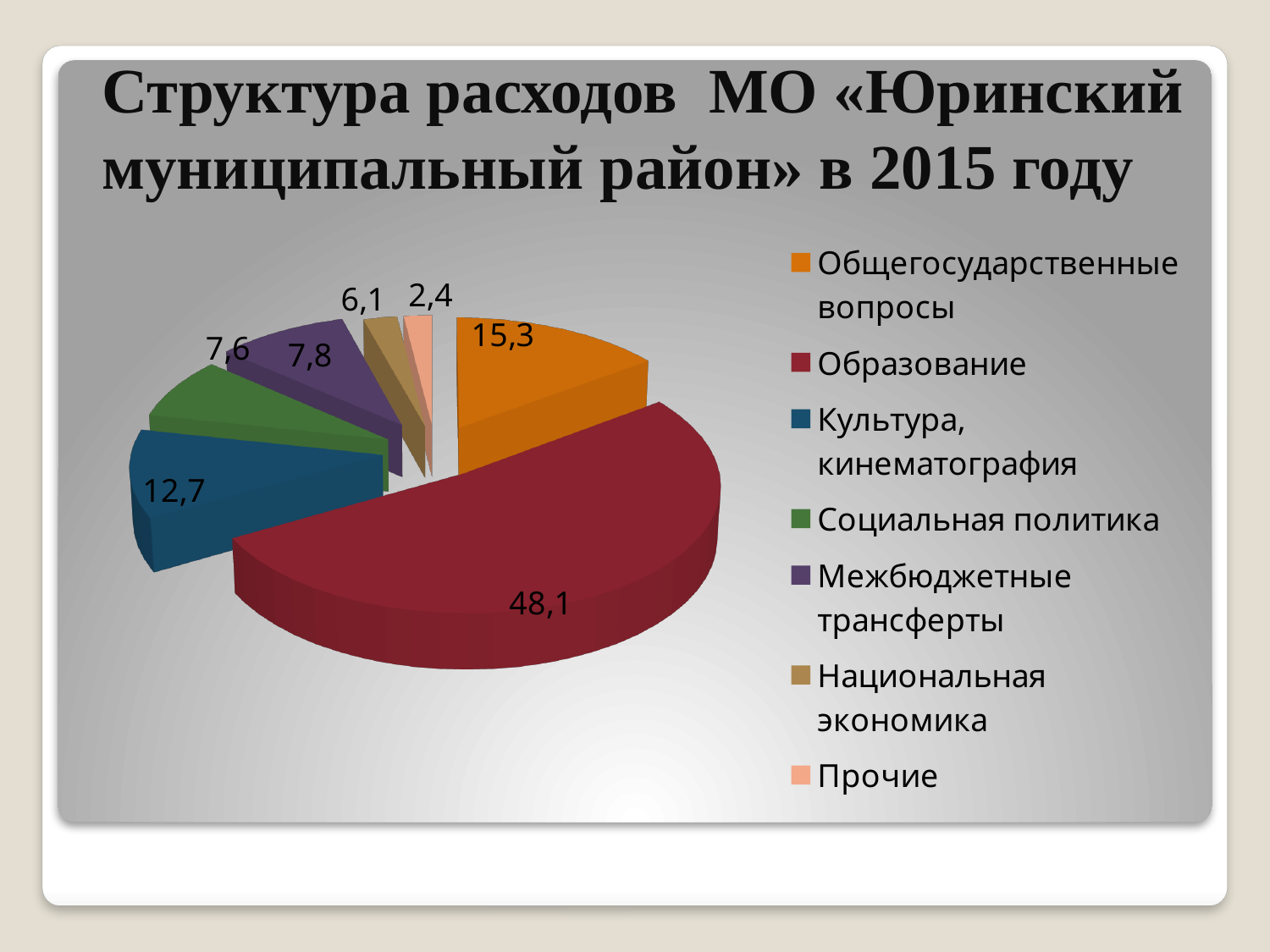
What is the value shown for Образование? 48,1 What type of chart is shown on the slide? Pie chart What colour is the slice for Социальная политика? Green What is the difference between the values for Образование and Общегосударственные вопросы? 32,8 Which category has the smallest slice of the pie? Прочие What is the value shown for Национальная экономика? 6,1 What is the value shown for Культура, кинематография? 12,7 What is the value shown for Межбюджетные трансферты? 7,8 How many categories does the pie chart have? 7 What is the value shown for Общегосударственные вопросы? 15,3 Which category has the largest slice of the pie? Образование Which is larger, the value for Культура, кинематография or the value for Социальная политика? Культура, кинематография